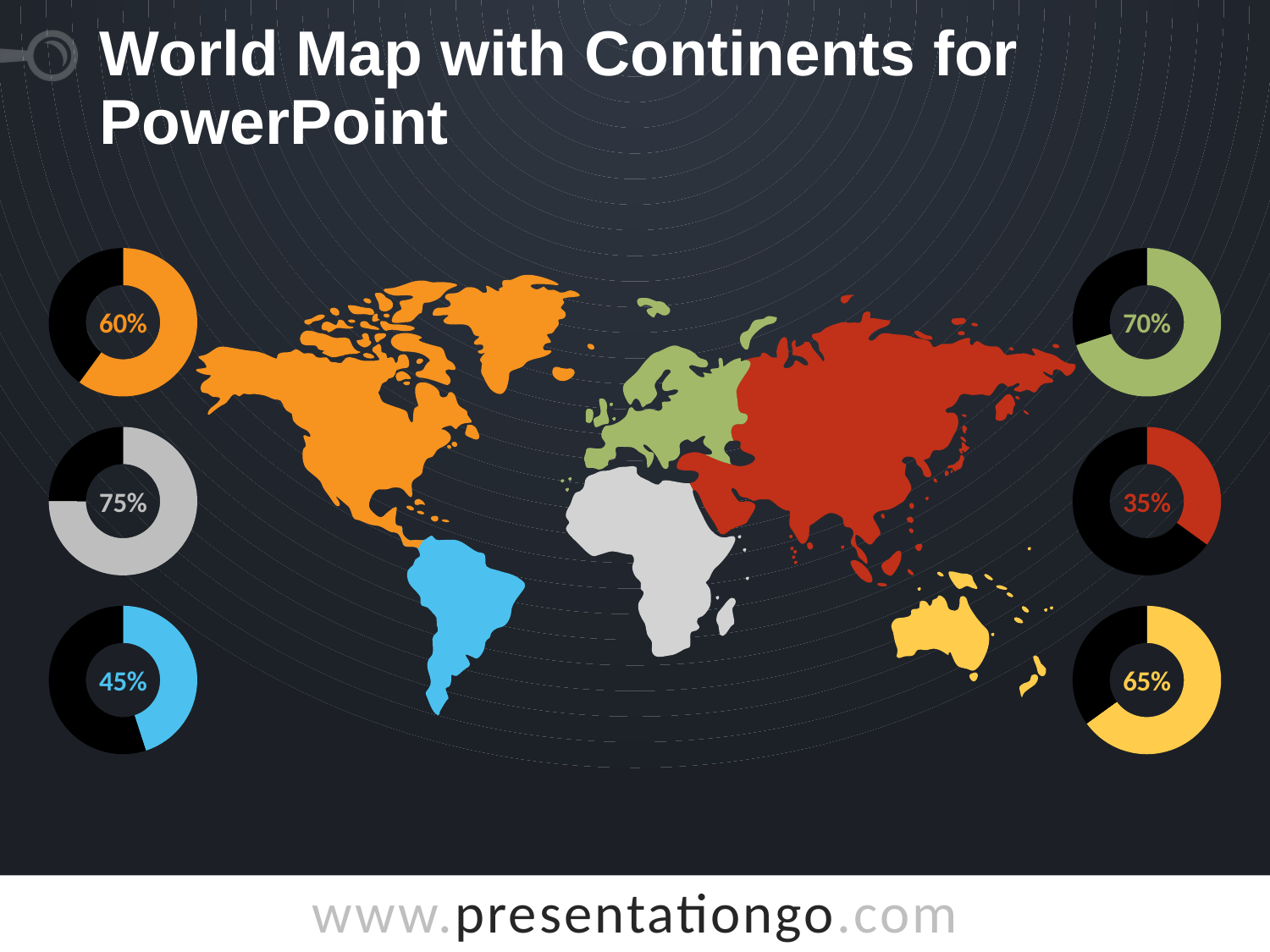
What value is shown in the green donut chart at the top right of the slide? 70% What value is shown in the red donut chart on the right side of the slide? 35% Which donut chart on the slide shows the lowest percentage? The red chart (35%) What value is shown in the blue donut chart at the bottom left of the slide? 45% What value is shown in the orange donut chart at the top left of the slide? 60% What value is shown in the grey donut chart on the left side of the slide? 75% Which donut chart on the slide shows the highest percentage? The grey chart (75%) What kind of charts are shown around the world map? Donut charts What value is shown in the yellow donut chart at the bottom right of the slide? 65% Which is larger, the value in the orange donut chart or the value in the yellow donut chart? The yellow chart (65%) What is the difference between the value in the grey donut chart and the value in the red donut chart? 40% How many donut charts are on the slide? 6